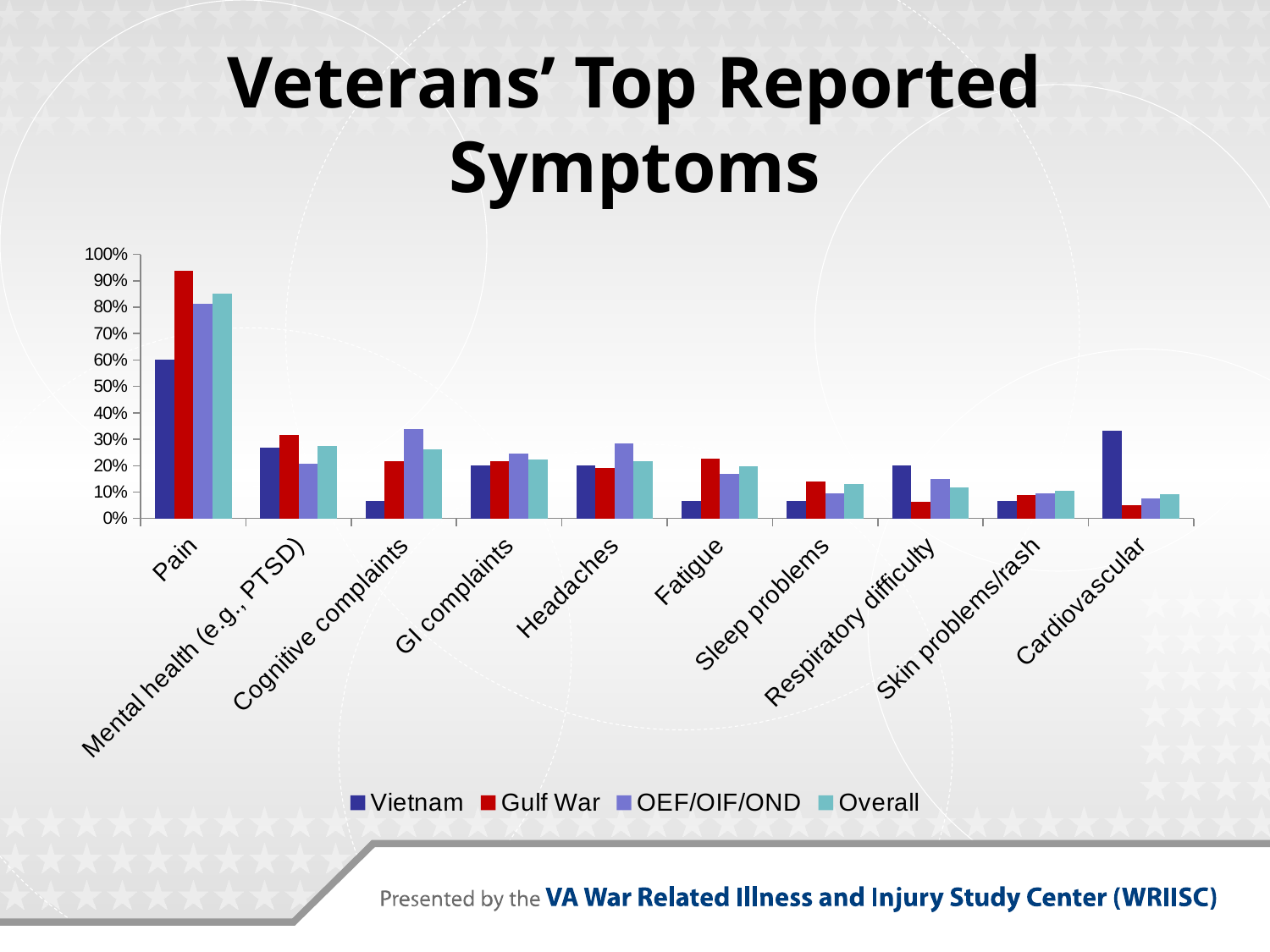
Is the Overall value for Pain greater or less than 80%? greater Which series has the lowest value for Cardiovascular? Gulf War Which series has the highest value for Pain? Gulf War What kind of chart is shown on the slide? bar chart Is the Gulf War value for Pain greater or less than 90%? greater What is the title of the chart? Veterans' Top Reported Symptoms How many series does the legend list? 4 How many symptom categories are shown on the x axis? 10 Is the Vietnam value for Cognitive complaints greater or less than 10%? less For Cognitive complaints, which is larger: the OEF/OIF/OND value or the Vietnam value? OEF/OIF/OND For Cardiovascular, which is larger: the Vietnam value or the Gulf War value? Vietnam Which symptom has the highest Gulf War value? Pain